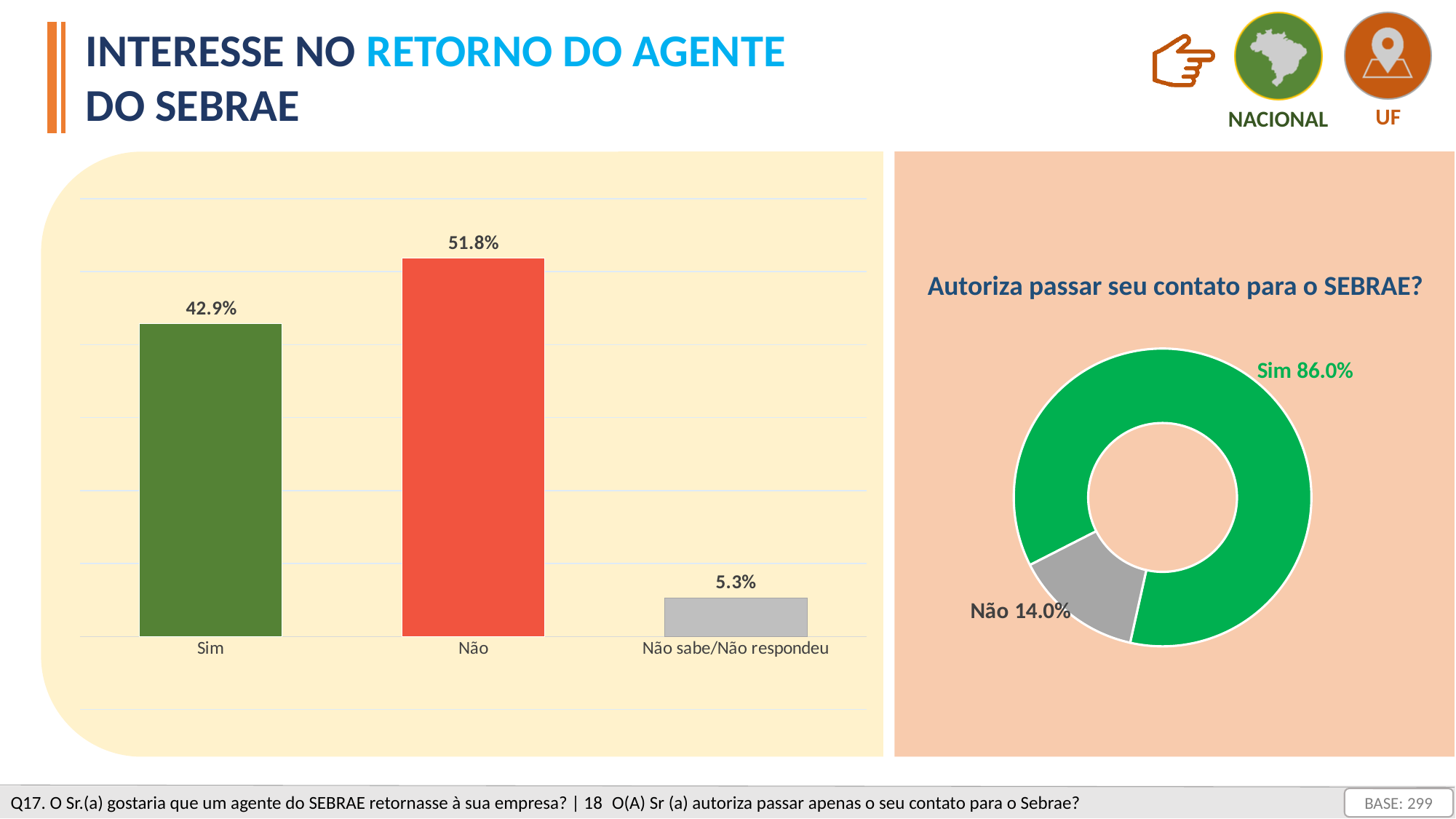
In the bar chart on the left, what is the difference between the values for "Não" and "Sim"? 8.9% What kind of chart is shown on the left side of the slide? Bar chart In the bar chart on the left, which category has the lowest value? Não sabe/Não respondeu In the bar chart on the left, what is the value for "Sim"? 42.9% In the chart titled "Autoriza passar seu contato para o SEBRAE?", what is the share for "Não"? 14.0% What kind of chart is titled "Autoriza passar seu contato para o SEBRAE?"? Doughnut chart In the bar chart on the left, which category has the highest value? Não In the bar chart on the left, what is the value for "Não sabe/Não respondeu"? 5.3% In the bar chart on the left, which is larger: the value for "Sim" or the value for "Não"? Não How many categories does the bar chart on the left show? 3 In the chart titled "Autoriza passar seu contato para o SEBRAE?", what is the share for "Sim"? 86.0% In the bar chart on the left, what is the value for "Não"? 51.8%